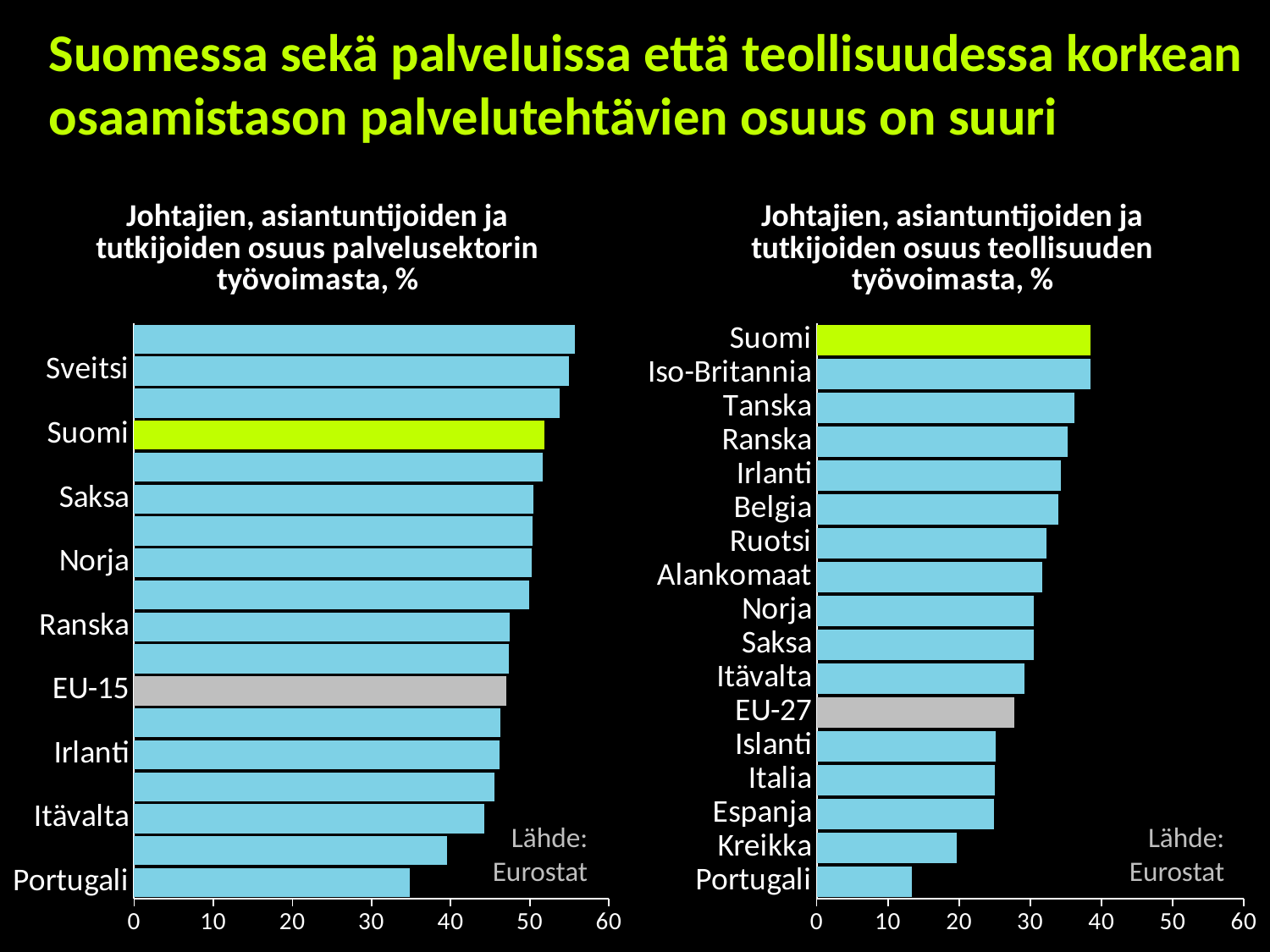
In the left-hand chart (palvelusektorin työvoimasta), which labelled category has the lowest value? Portugali How many bars are shown in the right-hand chart (teollisuuden työvoimasta)? 17 In the left-hand chart (palvelusektorin työvoimasta), is the value for EU-15 greater or less than 50? less What kind of chart is the right-hand chart (teollisuuden työvoimasta)? bar chart In the left-hand chart (palvelusektorin työvoimasta), is the value for Portugali greater or less than 40? less In the right-hand chart (teollisuuden työvoimasta), which country has the lowest value? Portugali In the right-hand chart (teollisuuden työvoimasta), which is larger, the value for Suomi or the value for EU-27? Suomi In the left-hand chart (palvelusektorin työvoimasta), is the value for Suomi greater or less than 50? greater What source is cited below both charts? Eurostat